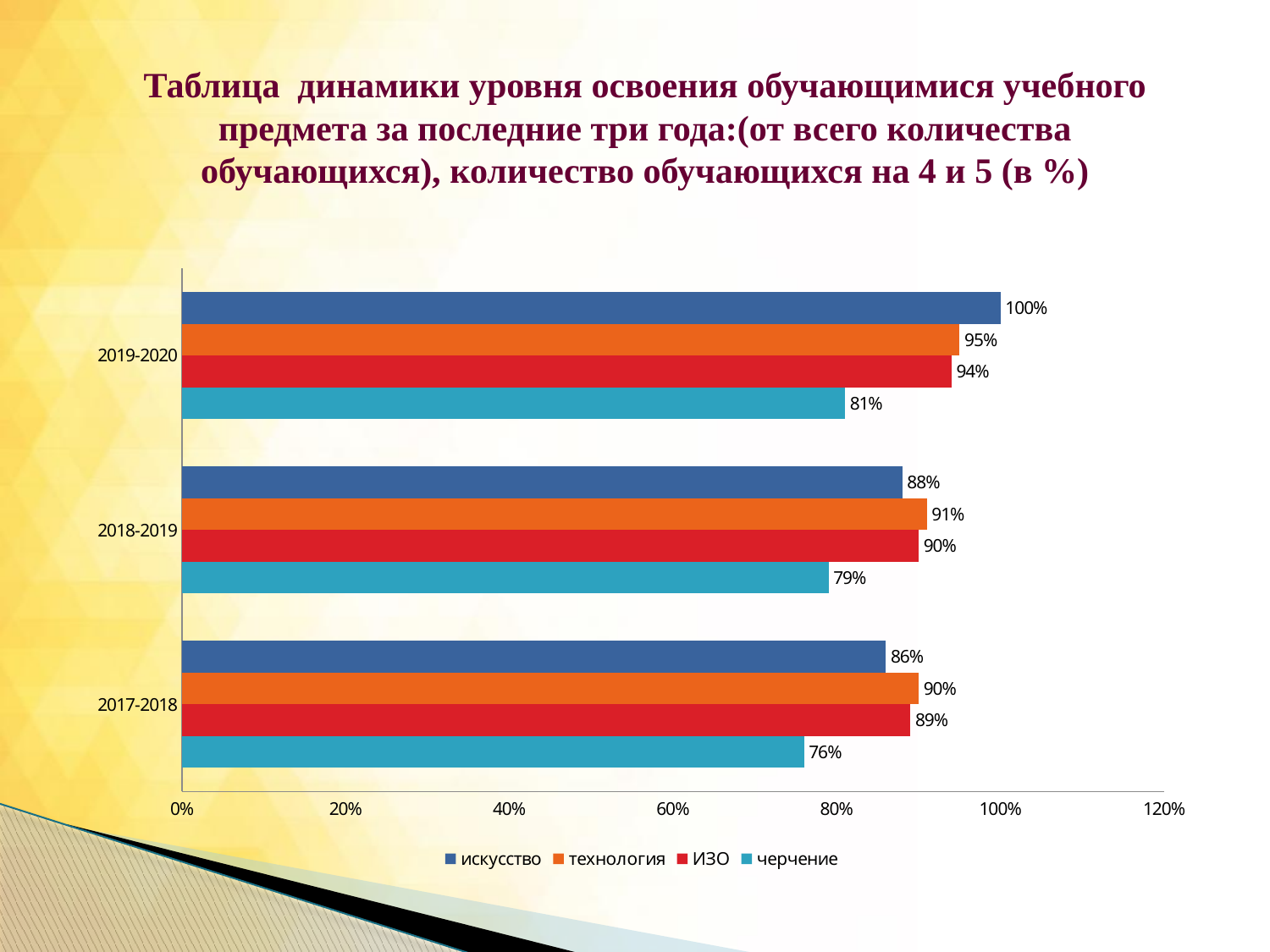
What is the value for черчение in 2017-2018? 76% What is the difference between the искусство values for 2019-2020 and 2017-2018? 14% Which series has the lowest value in 2018-2019? черчение How many year categories are shown on the chart? 3 How many series does the legend list? 4 Which series has the highest value in 2019-2020? искусство What is the value for технология in 2018-2019? 91% What is the value for искусство in 2019-2020? 100% What kind of chart is shown on the slide? bar chart What is the value for ИЗО in 2019-2020? 94% Which is larger: технология in 2017-2018 or искусство in 2017-2018? технология in 2017-2018 Do the черчение values rise or fall from 2017-2018 to 2019-2020? rise